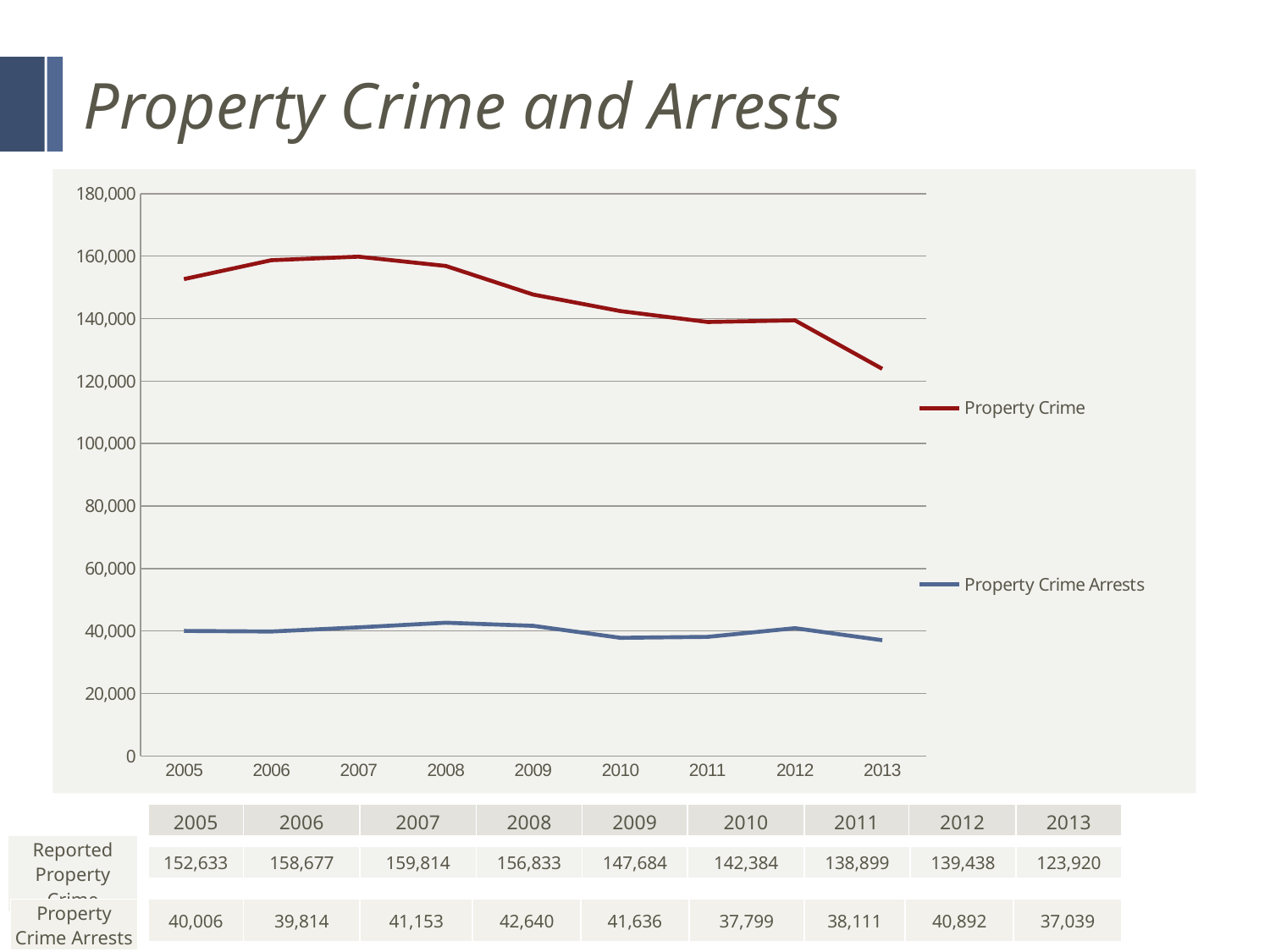
In which year was Property Crime lowest? 2013 What type of chart is shown on the slide? line chart What was the value of Property Crime in 2007? 159,814 What was the value of Property Crime Arrests in 2013? 37,039 Which is larger: Property Crime Arrests in 2008 or in 2010? 2008 How many years are plotted along the x axis? 9 Is the value for Property Crime in 2013 greater or less than 140,000? less What is the difference between Property Crime in 2012 and in 2013? 15,518 What colour is the Property Crime line? red In which year were Property Crime Arrests highest? 2008 How many series does the legend list? 2 In which year was Property Crime highest? 2007